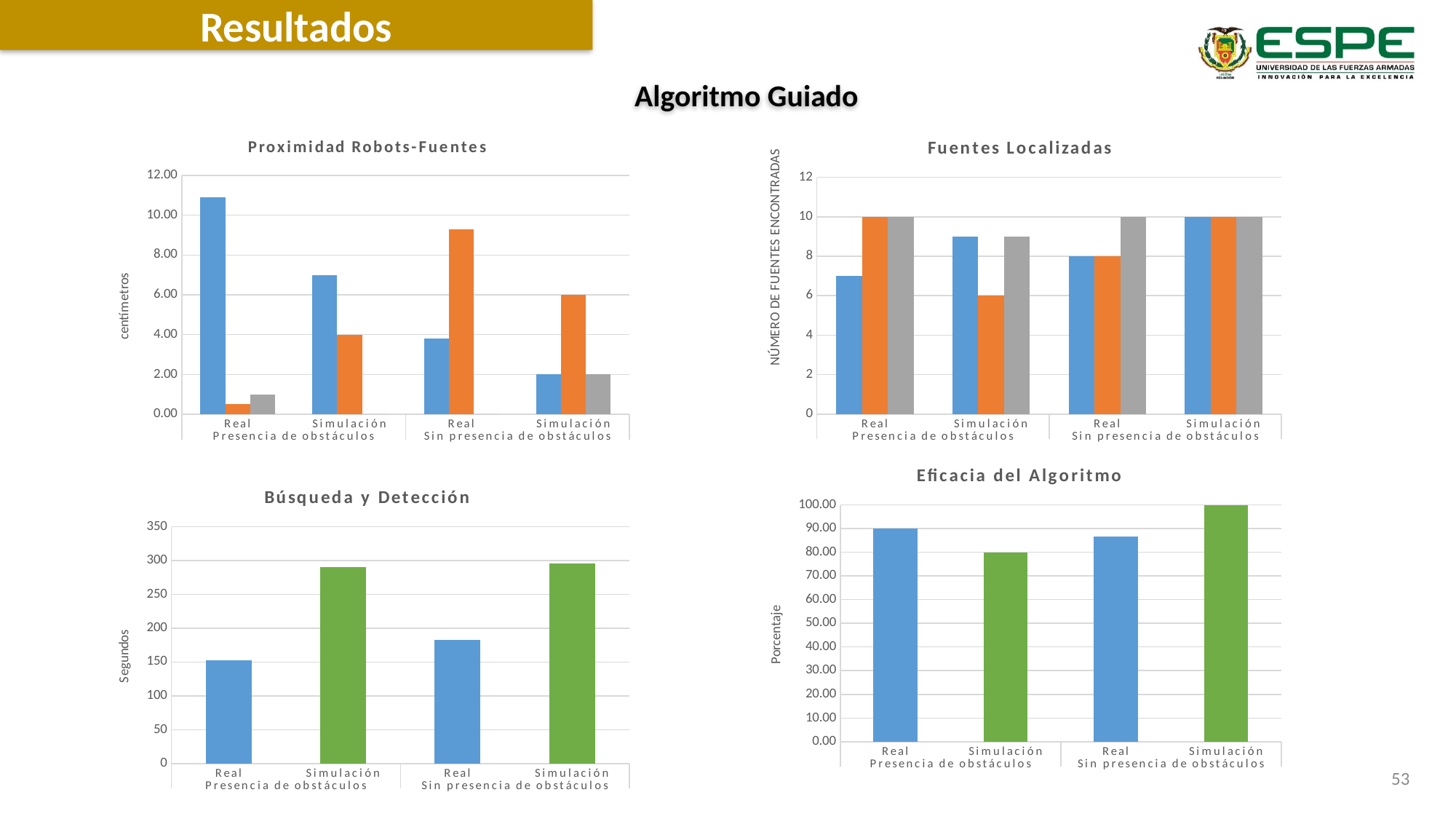
What type of chart is 'Búsqueda y Detección'? bar chart In the 'Fuentes Localizadas' chart, what is the value of the gray bar for Real under Sin presencia de obstáculos? 10 In the 'Búsqueda y Detección' chart, is the value for Real under Presencia de obstáculos greater or less than 200? less In the 'Fuentes Localizadas' chart, what is the value of the orange bar for Simulación under Presencia de obstáculos? 6 In the 'Proximidad Robots-Fuentes' chart, which is larger for Real under Sin presencia de obstáculos: the blue bar or the orange bar? the orange bar In the 'Eficacia del Algoritmo' chart, what is the value for Simulación under Sin presencia de obstáculos? 100.00 In the 'Proximidad Robots-Fuentes' chart, is the blue bar for Real under Presencia de obstáculos greater or less than 10.00? greater In the 'Eficacia del Algoritmo' chart, which category has the highest value? Simulación (Sin presencia de obstáculos) In the 'Búsqueda y Detección' chart, which is larger: Real under Presencia de obstáculos or Simulación under Presencia de obstáculos? Simulación In the 'Eficacia del Algoritmo' chart, is the value for Simulación under Presencia de obstáculos greater or less than 90.00? less